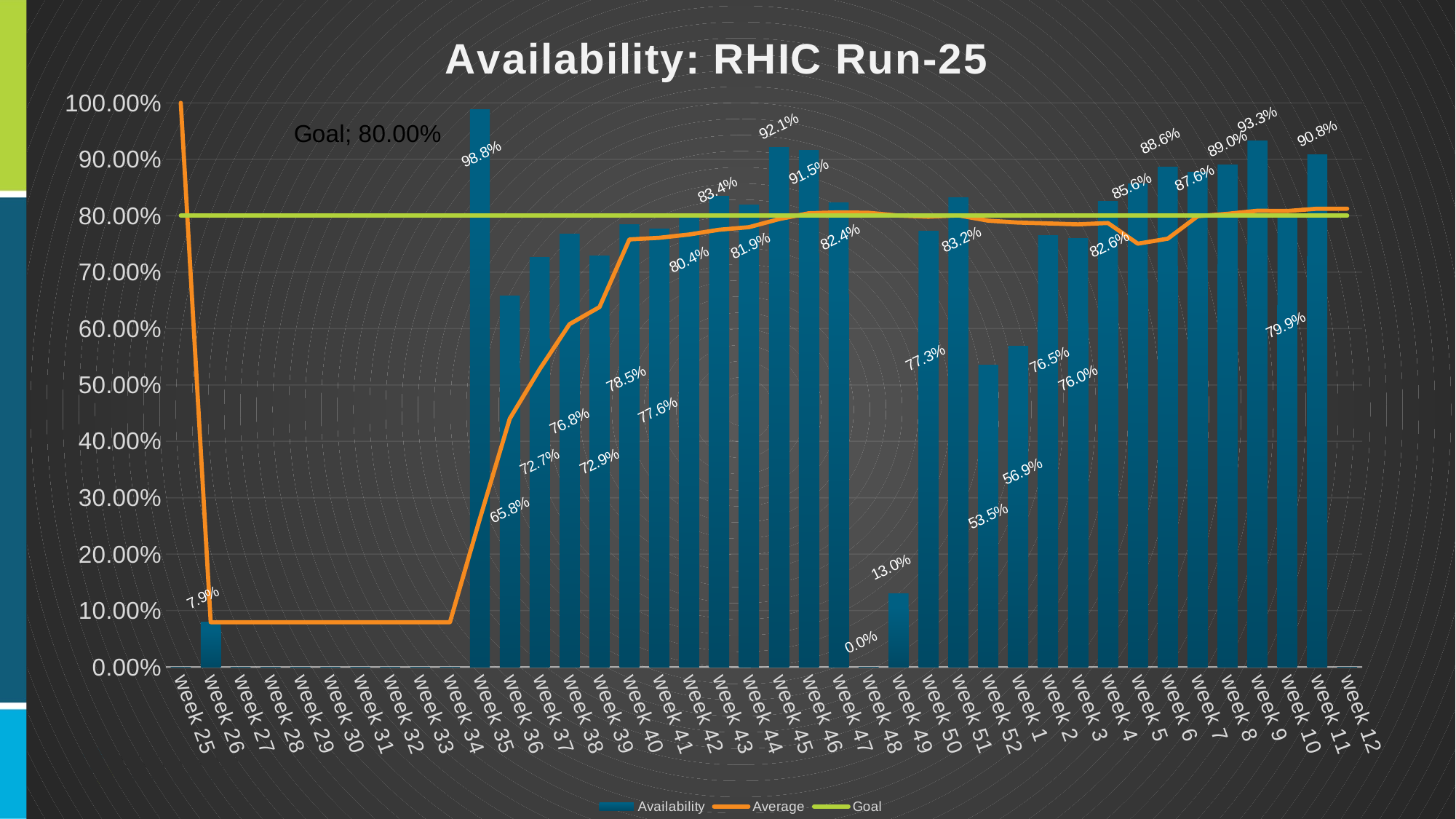
What is the lowest availability value labeled on the chart? 0.0% Is the availability value for week 26 greater or less than 10.00%? less What is the goal value shown on the chart? 80.00% How many series does the legend list? 3 What kind of chart is used to show the Availability series? bar chart What is the highest availability value labeled on the chart? 98.8% What is the difference between the highest labeled availability value (98.8%) and the week 26 value (7.9%)? 90.9% What is the title of the chart? Availability: RHIC Run-25 What are the three entries in the legend? Availability, Average, Goal What is the availability value for week 26? 7.9% Does the Average line rise or fall between week 34 and week 40? rise How many weeks are shown on the x axis? 40